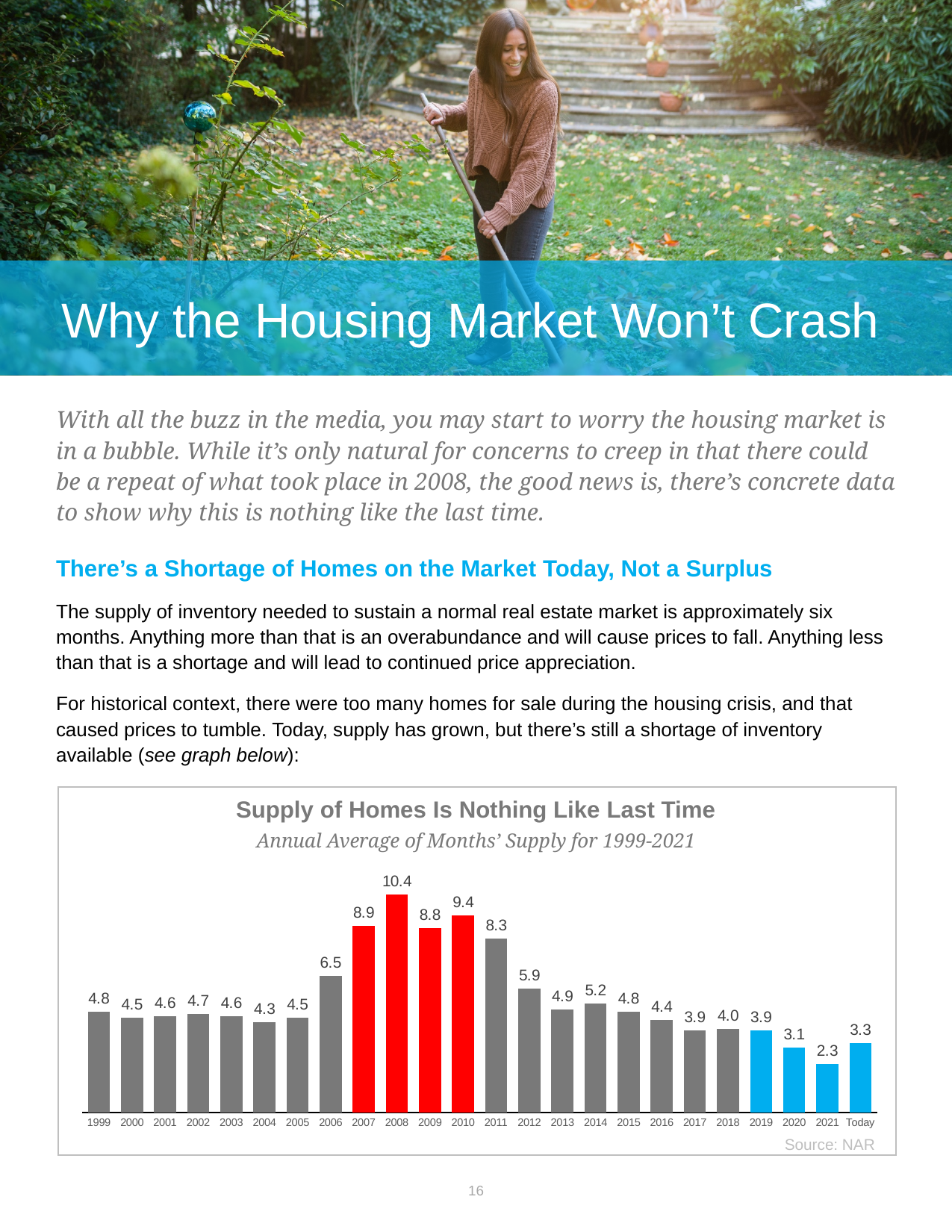
Which year has the lowest value in the chart? 2021 What kind of chart is shown on the slide? Bar chart What is the value for Today in the chart? 3.3 What is the value for 2008 in the chart? 10.4 What is the difference between the values for 2008 and Today? 7.1 What is the title of the chart? Supply of Homes Is Nothing Like Last Time Which is larger, the value for 2010 or the value for 2009? 2010 How many bars are plotted in the chart? 24 What is the value for 2011 in the chart? 8.3 What is the value for 2021 in the chart? 2.3 Which year has the highest value in the chart? 2008 What is the difference between the values for 2006 and 2007? 2.4